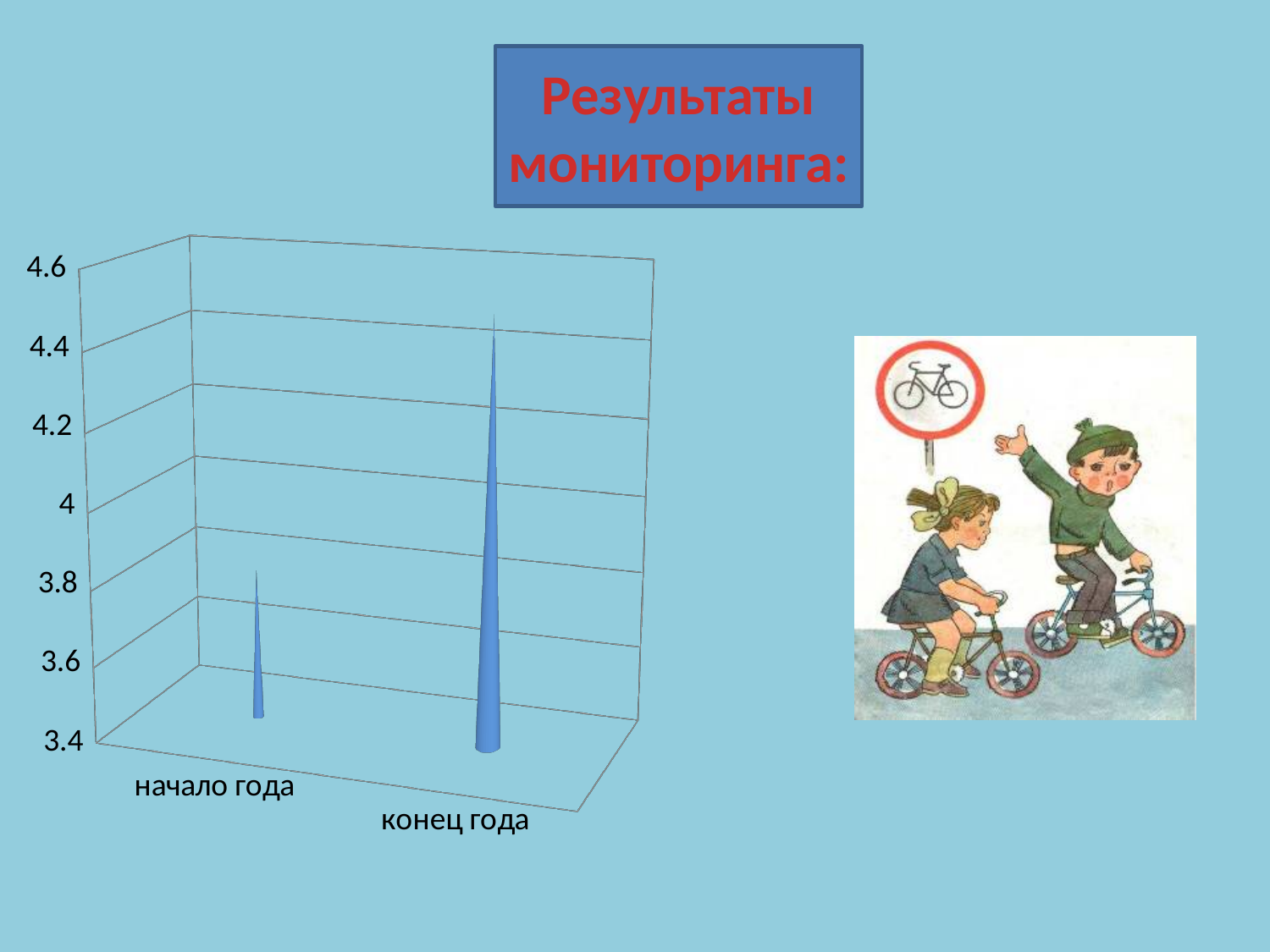
Which is larger, the value for начало года or the value for конец года? конец года Is the value for конец года greater or less than 4.2? greater Is the value for конец года greater or less than 4? greater Do the values rise or fall from начало года to конец года? rise What kind of chart is shown on the slide? bar chart What is the title shown above the chart on the slide? Результаты мониторинга: Is the value for начало года greater or less than 3.6? greater How many categories are plotted on the chart? 2 Which category has the lowest value? начало года What is the highest value labelled on the vertical axis of the chart? 4.6 Which category has the highest value? конец года